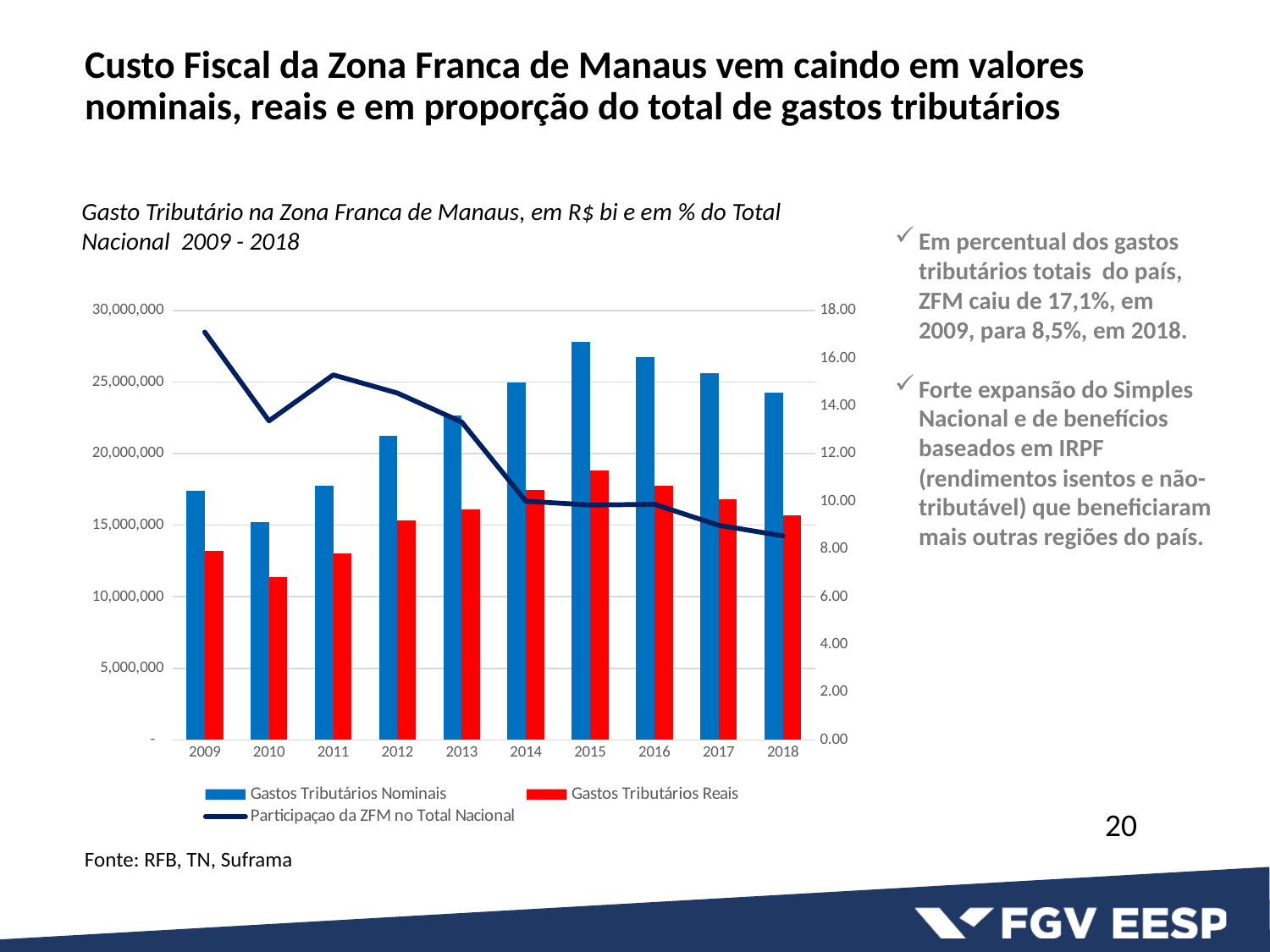
What kind of chart is shown on the slide? A combined bar and line chart Is the value of Gastos Tributários Nominais for 2015 greater or less than 25,000,000? greater How many years are shown on the x axis of the chart? 10 In which year are the Gastos Tributários Reais highest? 2015 In which year is the Participaçao da ZFM no Total Nacional line at its lowest? 2018 Is the value of Gastos Tributários Reais for 2010 greater or less than 10,000,000? greater How many series does the chart legend list? 3 In which year are the Gastos Tributários Nominais highest? 2015 Is the Participaçao da ZFM no Total Nacional for 2018 greater or less than 10.00? less In which year are the Gastos Tributários Nominais lowest? 2010 Does the Participaçao da ZFM no Total Nacional line generally rise or fall from 2009 to 2018? Fall Which year has the larger value of Gastos Tributários Nominais, 2016 or 2017? 2016